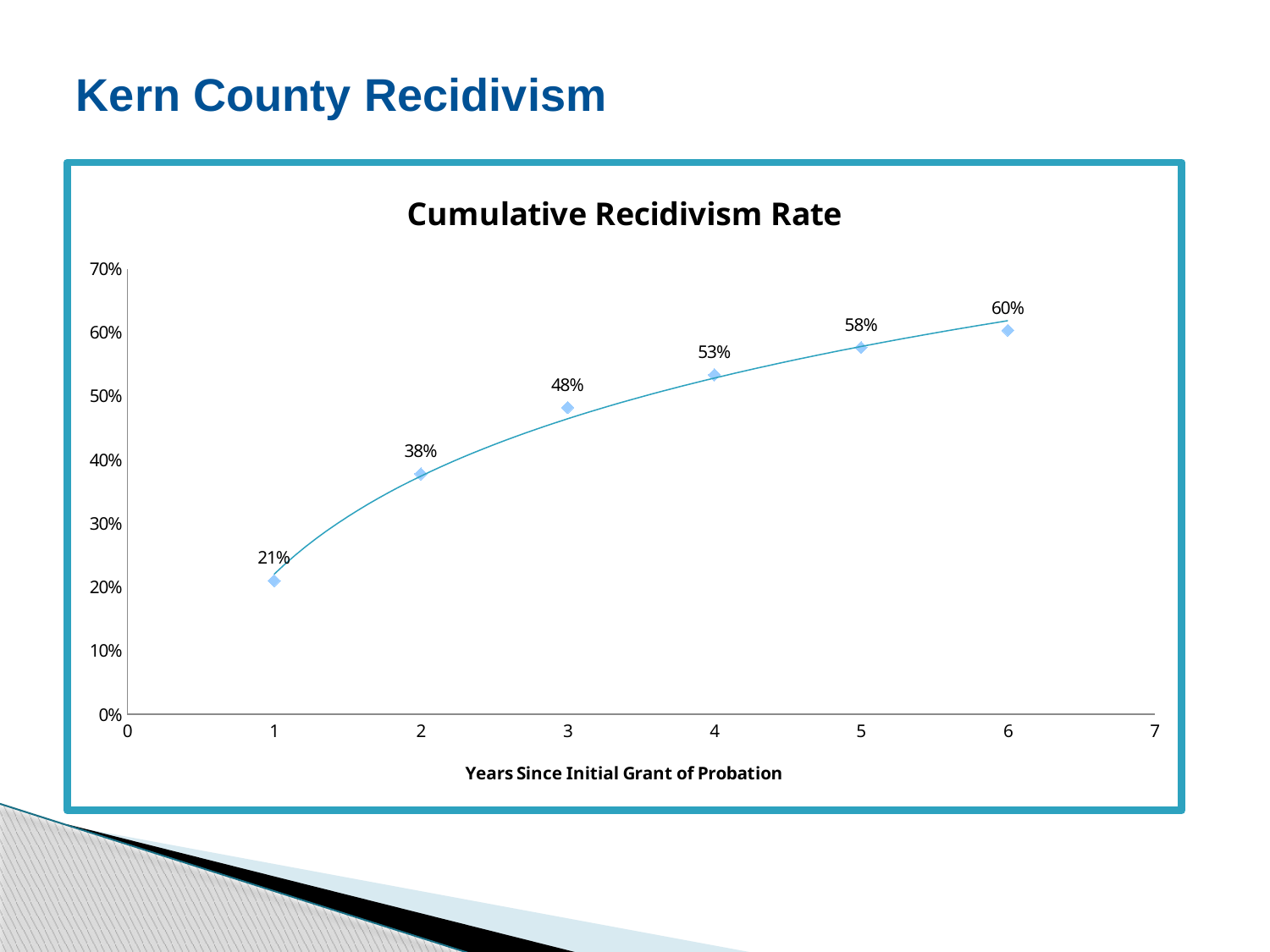
Is the cumulative recidivism rate at 5 years greater or less than 50%? greater What is the difference between the cumulative recidivism rate at 6 years and at 5 years? 2% What is the cumulative recidivism rate at 6 years since initial grant of probation? 60% At how many years is the cumulative recidivism rate highest? 6 Does the cumulative recidivism rate rise or fall as years since initial grant of probation increase? rise What is the cumulative recidivism rate at 3 years since initial grant of probation? 48% What is the difference between the cumulative recidivism rate at 2 years and at 1 year? 17% At how many years is the cumulative recidivism rate lowest? 1 Which is larger, the cumulative recidivism rate at 4 years or at 2 years? 4 years What is the cumulative recidivism rate at 1 year since initial grant of probation? 21% What is the x-axis label of the chart? Years Since Initial Grant of Probation How many data points are plotted on the chart? 6